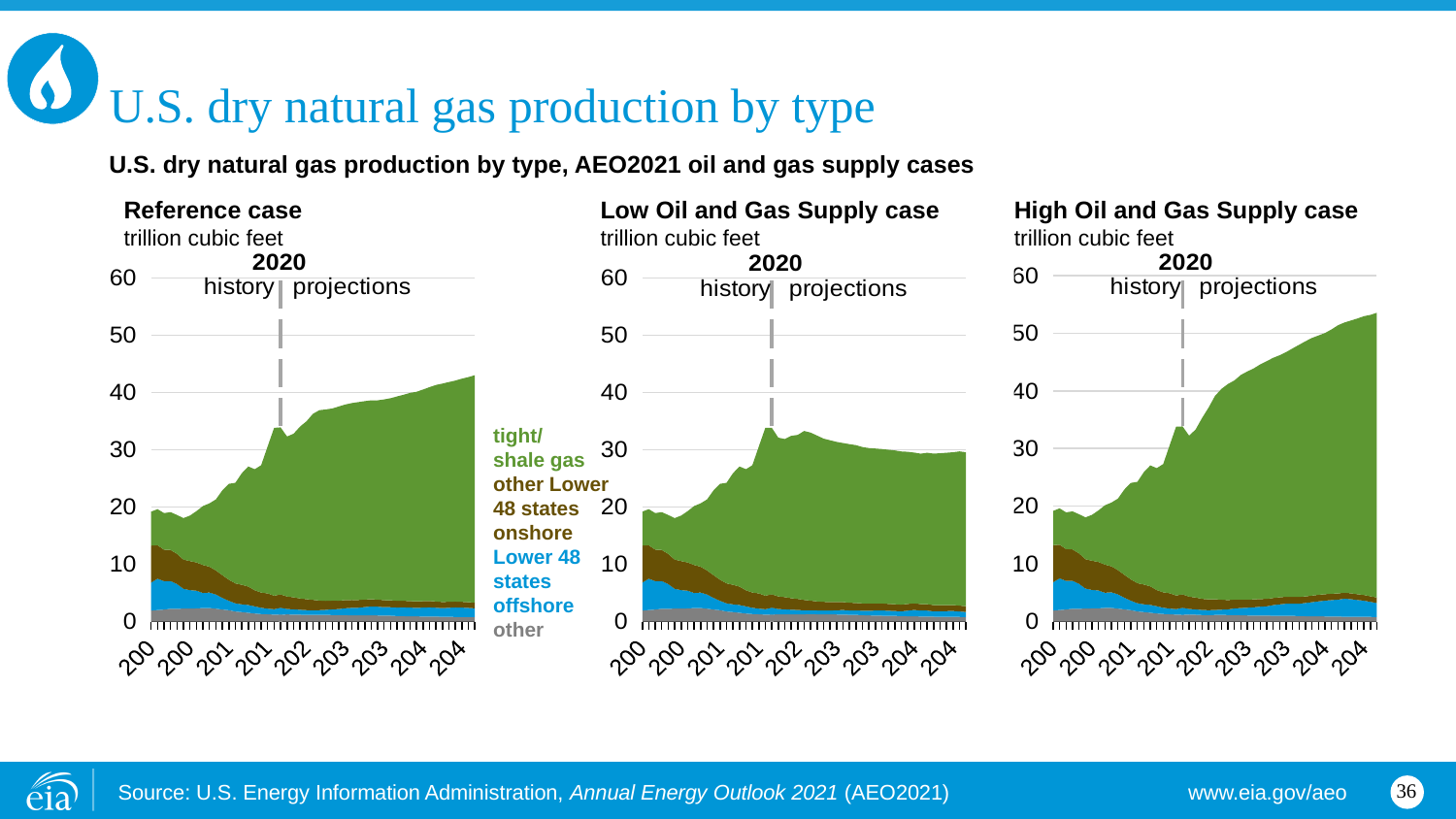
What unit is used on the y axis of the three charts? trillion cubic feet In the Reference case chart, is the total production at the end of the projection period greater or less than 40? greater Which chart shows the highest total production at the end of the projection period? High Oil and Gas Supply case At the end of the projection period, is total production larger in the High Oil and Gas Supply case chart or the Low Oil and Gas Supply case chart? High Oil and Gas Supply case In the High Oil and Gas Supply case chart, is the total production at the end of the projection period greater or less than 50? greater In the Low Oil and Gas Supply case chart, is the total production at the end of the projection period greater or less than 40? less How many series does the legend list for the charts? 4 Which series makes up the largest share of production in the Reference case chart during the projection period? tight/shale gas In the High Oil and Gas Supply case chart, does total production rise or fall over the projection period? rise What kind of chart is the Reference case chart? stacked area chart In the Low Oil and Gas Supply case chart, does total production rise or fall from its peak just after 2020 to the end of the projection period? fall